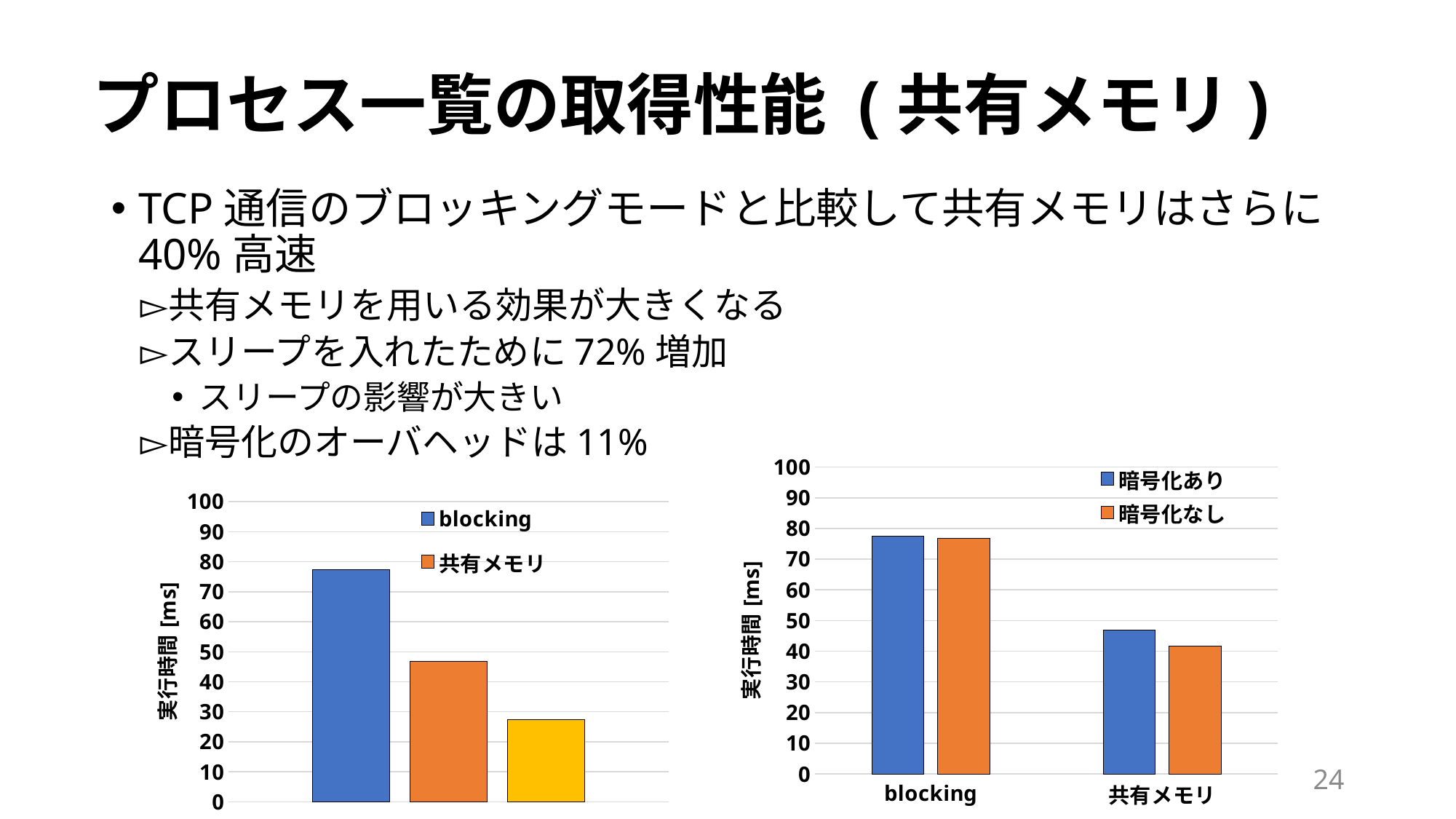
In the chart on the left, is the value for 共有メモリ greater or less than 50? less In the chart on the left, how many bars are plotted? 3 What is the y-axis title of the chart on the right? 実行時間 [ms] What kind of chart is the chart on the right of the slide? bar chart In the chart on the right, is the 暗号化あり value for 共有メモリ greater or less than 50? less In the chart on the left, which legend entry has the highest bar? blocking In the chart on the right, how many categories are shown on the x axis? 2 In the chart on the left, is the value for blocking greater or less than 70? greater In the chart on the right, for the 暗号化あり series, which is larger: blocking or 共有メモリ? blocking What kind of chart is the chart on the left of the slide? bar chart In the chart on the right, how many series does the legend list? 2